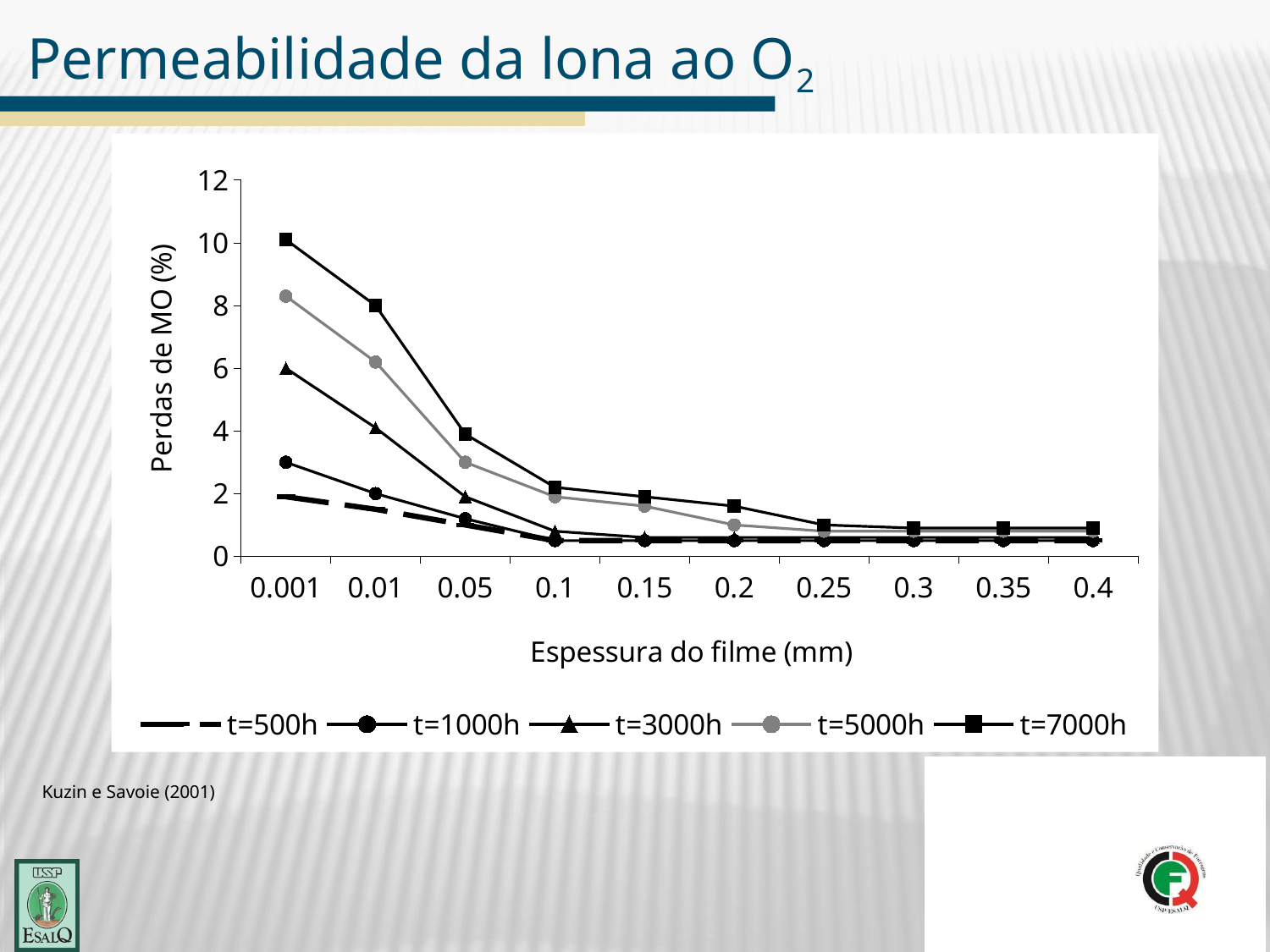
Do the values for t=7000h rise or fall as film thickness increases along the x axis? fall Is the value for t=5000h at 0.01 mm greater or less than 4? greater What is the title of the x axis? Espessura do filme (mm) Which series has the lowest value at a film thickness of 0.001 mm? t=500h How many series does the legend list? 5 What is the title of the y axis? Perdas de MO (%) What kind of chart is shown on the slide? line chart Is the value for t=3000h at 0.05 mm greater or less than 4? less How many film thickness values are shown along the x axis? 10 At a film thickness of 0.01 mm, which is larger: t=5000h or t=1000h? t=5000h Which series has the highest value at a film thickness of 0.001 mm? t=7000h Is the value for t=7000h at 0.001 mm greater or less than 8? greater